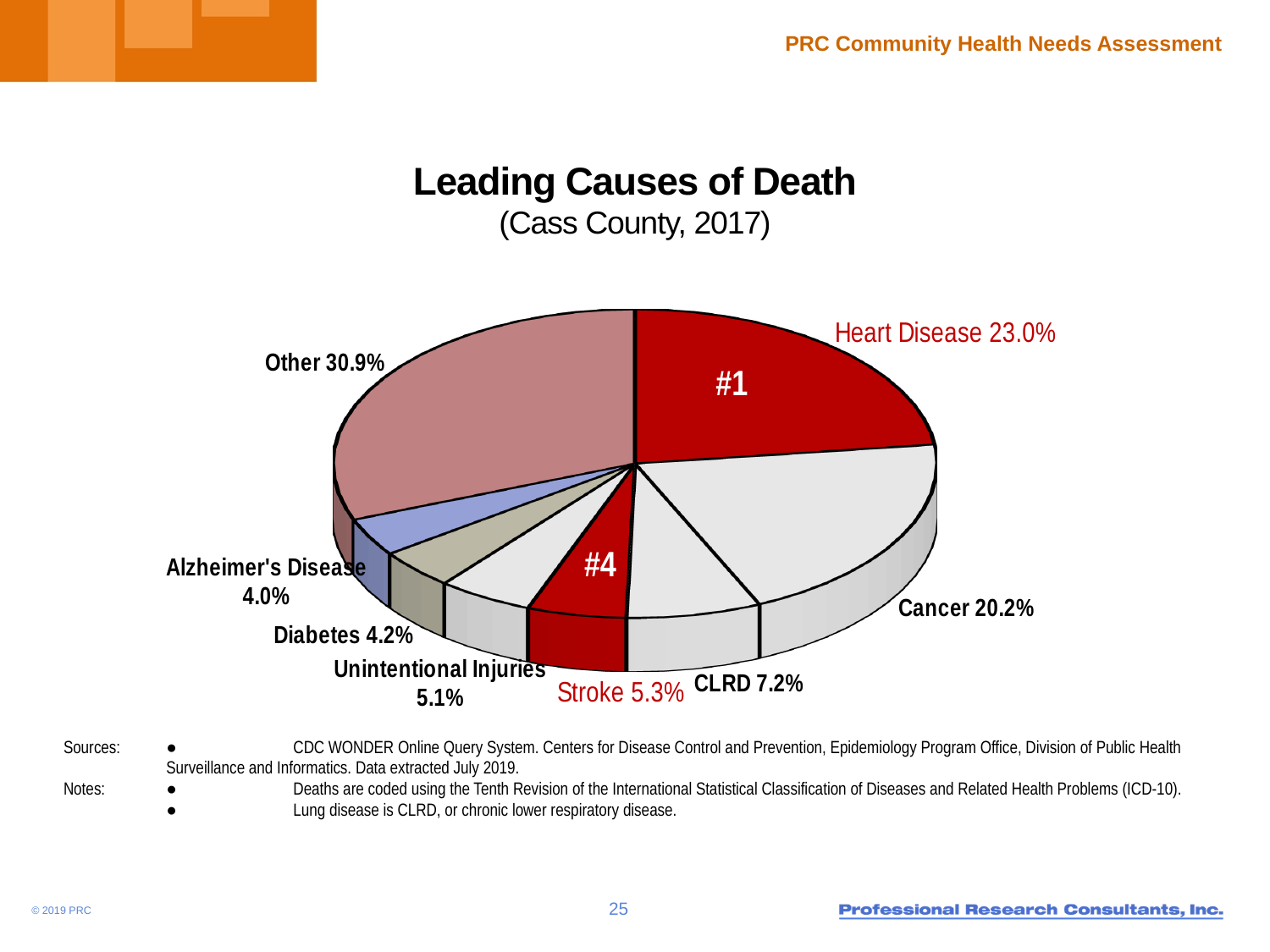
What is the title of the chart? Leading Causes of Death (Cass County, 2017) What share of deaths is attributed to Cancer? 20.2% Which cause of death has the smallest slice? Alzheimer's Disease How many slices does the pie chart have? 8 What kind of chart is shown on the slide? Pie chart What share of deaths is attributed to Diabetes? 4.2% Which is larger, the share for Unintentional Injuries or the share for Diabetes? Unintentional Injuries What share of deaths is attributed to Stroke? 5.3% What is the difference between the Heart Disease share and the Cancer share? 2.8% Which named cause of death (excluding Other) has the largest slice? Heart Disease What share of deaths is attributed to CLRD? 7.2% What share of deaths is attributed to Heart Disease? 23.0%